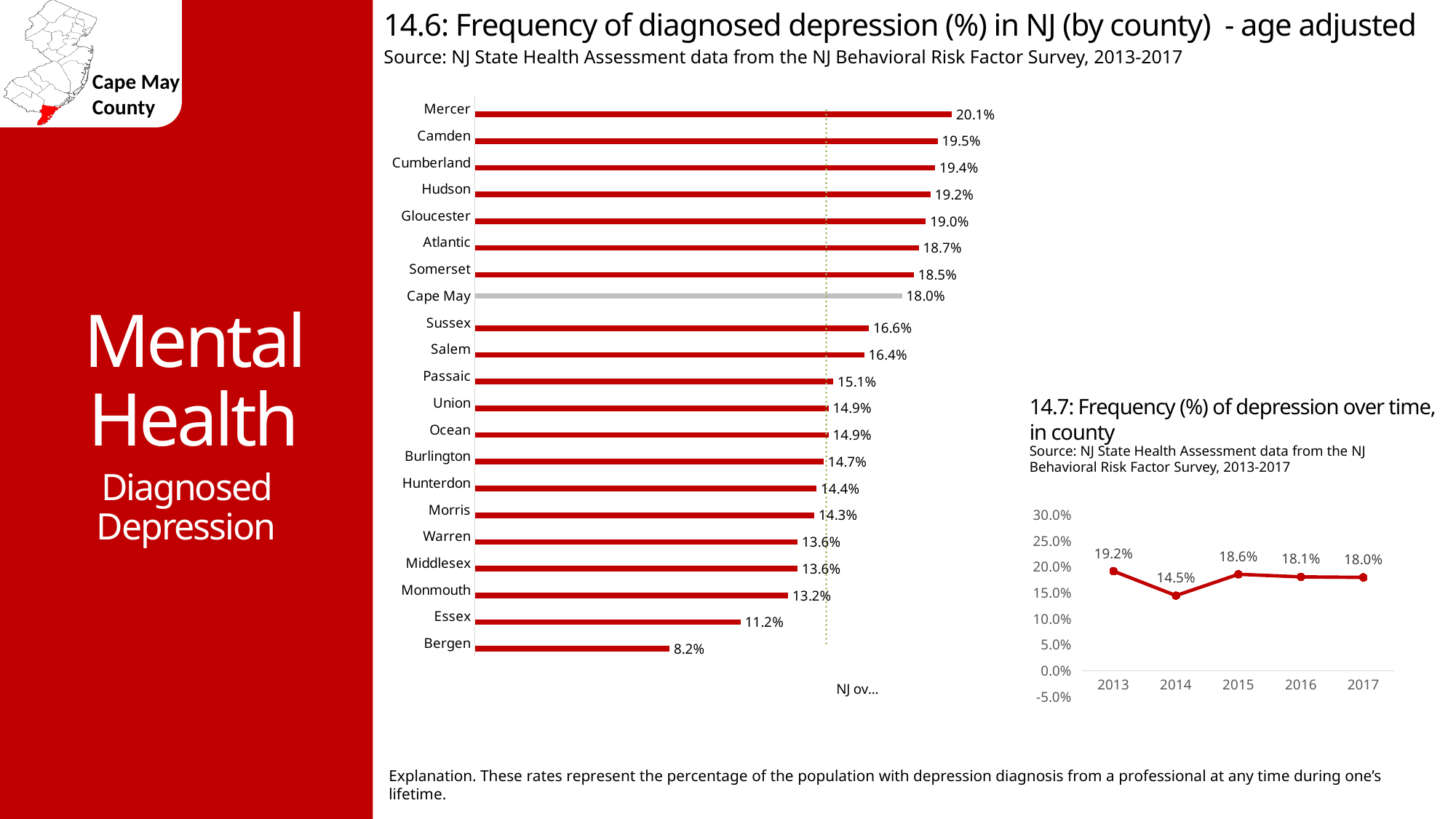
In the chart 14.7 (frequency of depression over time), what is the value for 2014? 14.5% In the chart 14.6 (frequency of diagnosed depression by county), what is the value for Essex? 11.2% In the chart 14.6 (frequency of diagnosed depression by county), how many counties are plotted? 21 In the chart 14.7 (frequency of depression over time), what is the difference between the values for 2013 and 2017? 1.2% In the chart 14.6 (frequency of diagnosed depression by county), which county has the lowest value? Bergen In the chart 14.7 (frequency of depression over time), which year has the lowest value? 2014 In the chart 14.6 (frequency of diagnosed depression by county), what is the difference between the values for Mercer and Bergen? 11.9% In the chart 14.6 (frequency of diagnosed depression by county), what is the value for Cape May? 18.0% What kind of chart is chart 14.6 (frequency of diagnosed depression by county)? Bar chart In the chart 14.7 (frequency of depression over time), do the values rise or fall from 2015 to 2017? Fall In the chart 14.6 (frequency of diagnosed depression by county), which county has the highest value? Mercer In the chart 14.6 (frequency of diagnosed depression by county), which is larger, the value for Sussex or the value for Passaic? Sussex